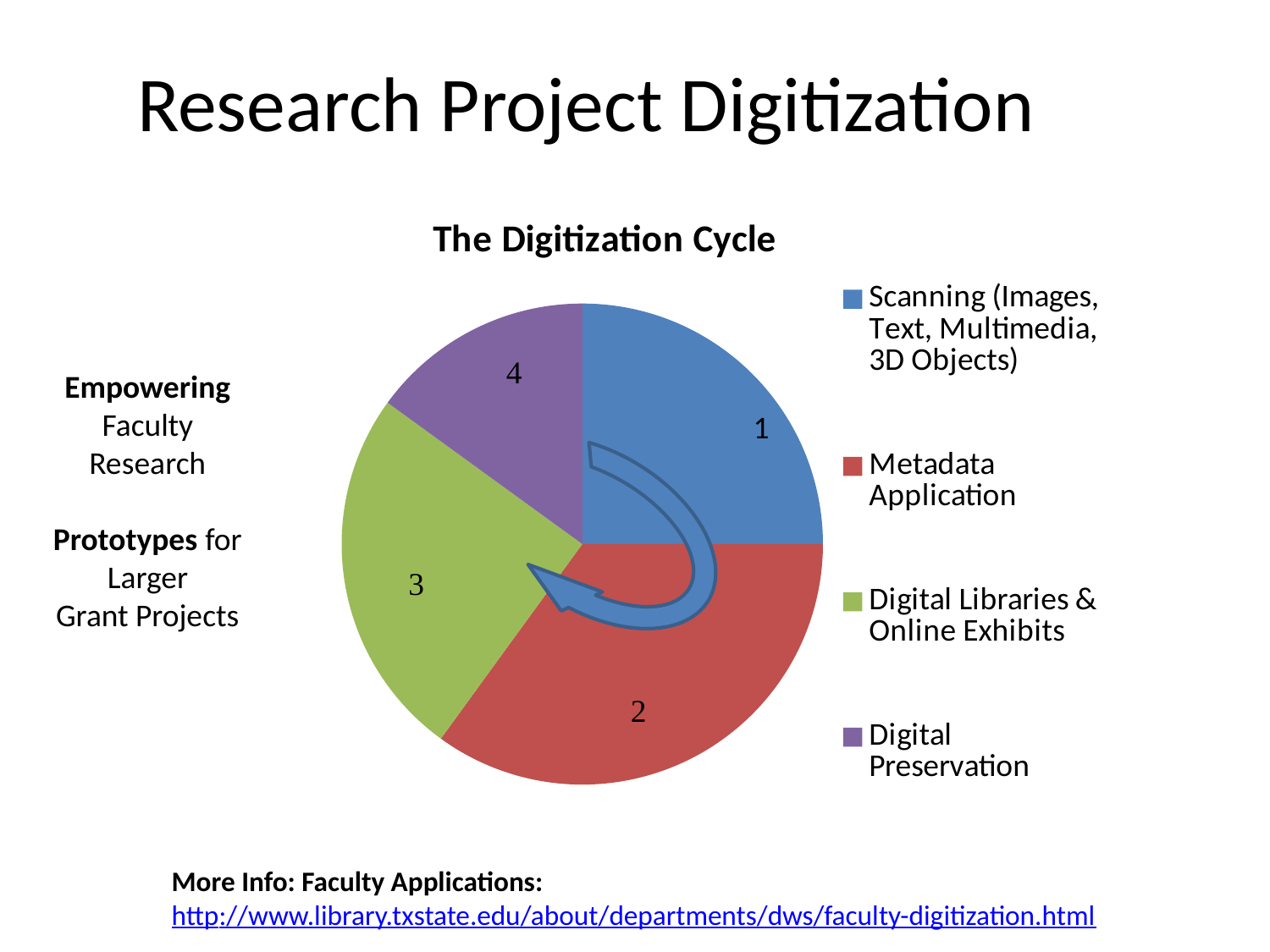
How many slices does the pie chart have? 4 How many entries does the chart legend list? 4 What number is printed on the Scanning (Images, Text, Multimedia, 3D Objects) slice? 1 Which category has the largest slice of the pie? Metadata Application Which slice is larger, Digital Libraries & Online Exhibits or Digital Preservation? Digital Libraries & Online Exhibits Which slice is larger, Metadata Application or Digital Preservation? Metadata Application What number is printed on the Digital Libraries & Online Exhibits slice? 3 Which category has the smallest slice of the pie? Digital Preservation What colour is the Digital Preservation slice? purple What is the title of the chart? The Digitization Cycle Which slice is larger, Metadata Application or Scanning (Images, Text, Multimedia, 3D Objects)? Metadata Application What kind of chart is shown on the slide? pie chart